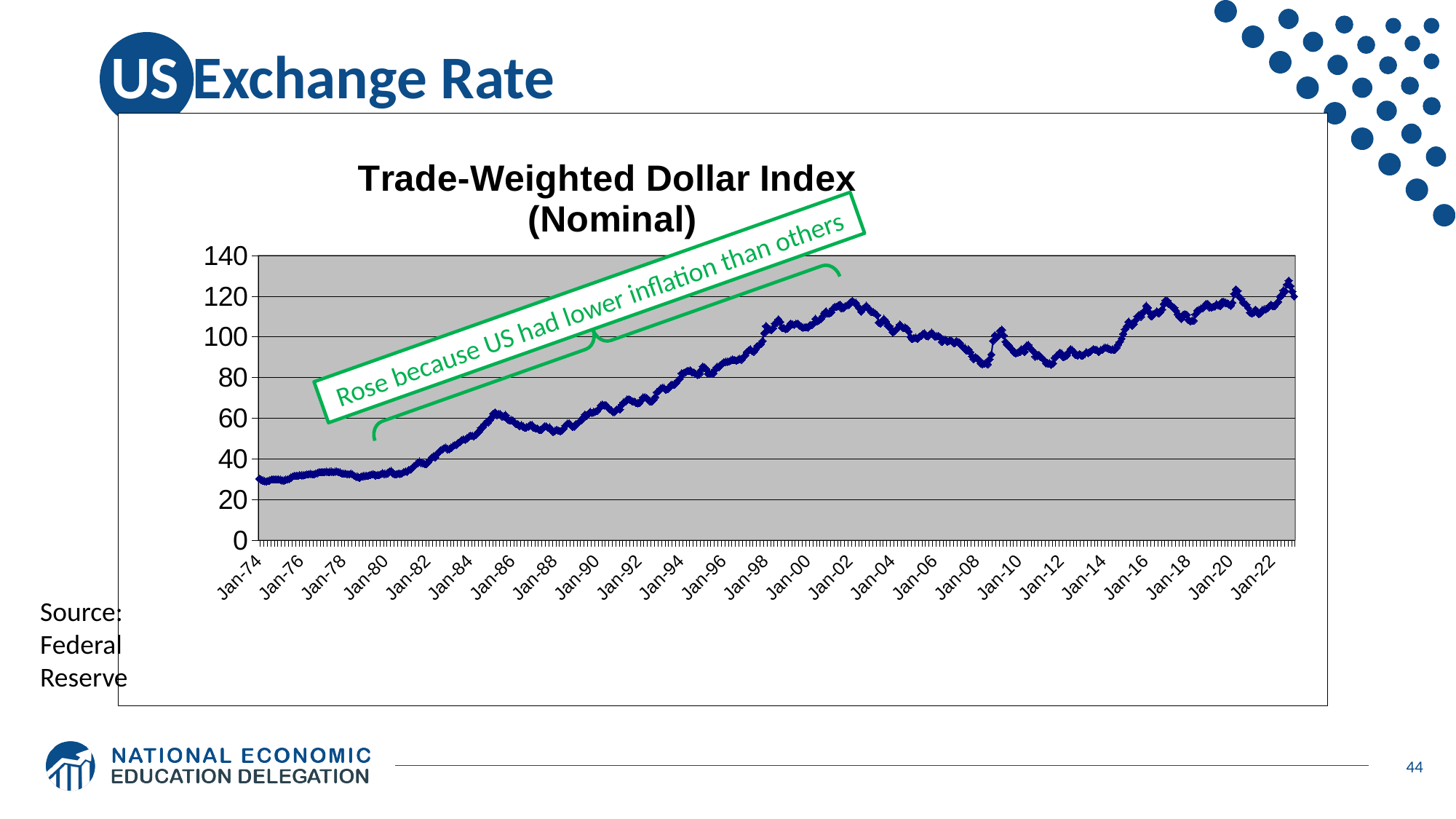
How many date labels are shown on the x axis? 25 What is the highest value shown on the y axis? 140 Which is larger, the index value at Jan-74 or at Jan-22? Jan-22 Is the value of the index at Jan-22 greater or less than 100? greater What kind of chart is shown on the slide? Line chart Is the value of the index at Jan-86 greater or less than 40? greater Which is larger, the index value at Jan-02 or at Jan-12? Jan-02 Is the value of the index at Jan-12 greater or less than 100? less What is the title of the chart? Trade-Weighted Dollar Index (Nominal) Overall, does the Trade-Weighted Dollar Index rise or fall from Jan-74 to Jan-22? Rise